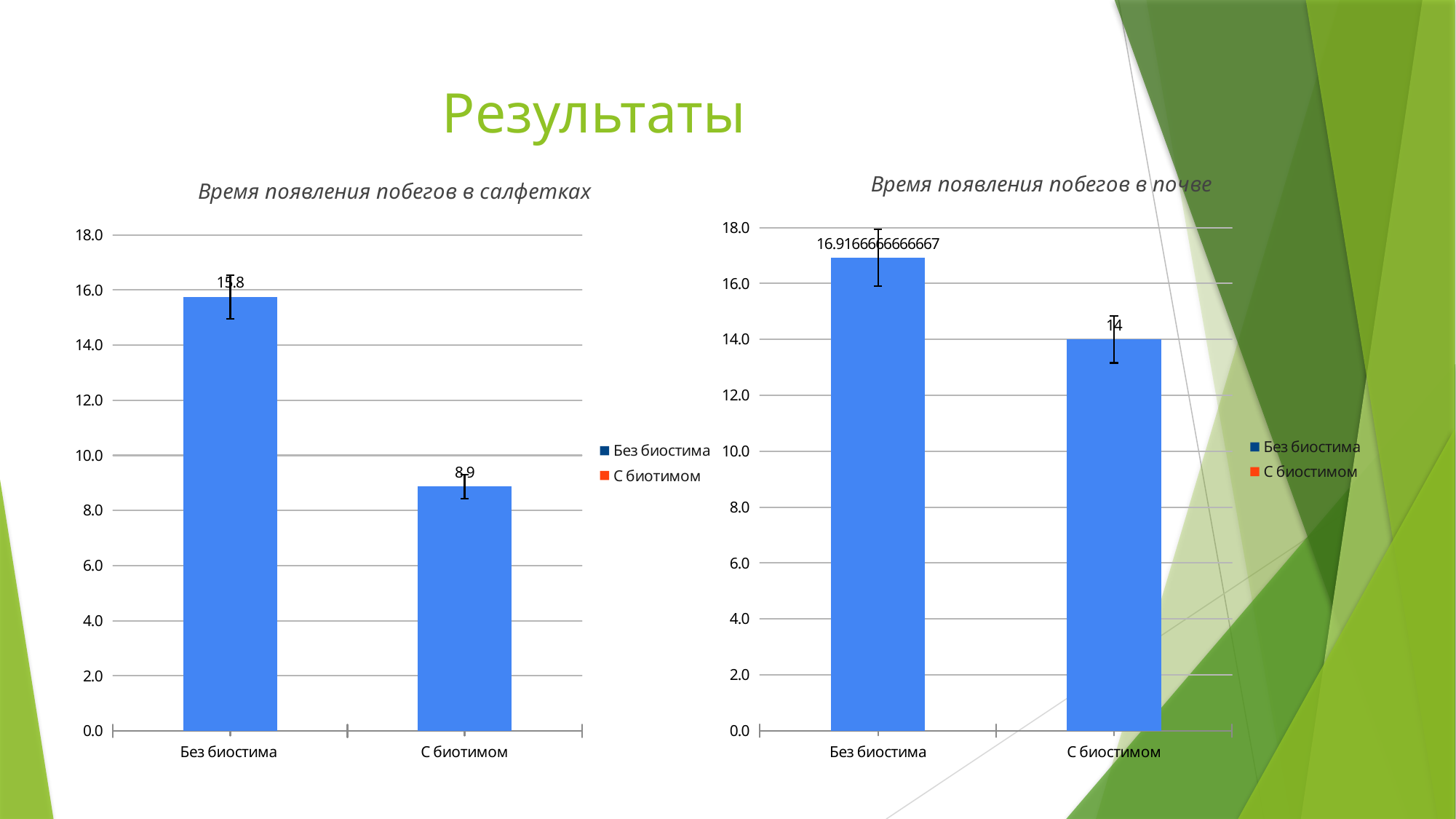
What kind of chart is the chart on the right side of the slide? Bar chart In the chart titled 'Время появления побегов в салфетках', what is the difference between the values for 'Без биостима' and 'С биотимом'? 6.9 How many categories are shown in the chart titled 'Время появления побегов в почве'? 2 In the chart titled 'Время появления побегов в почве', which is larger: the value for 'Без биостима' or for 'С биостимом'? Без биостима In the chart titled 'Время появления побегов в салфетках', what is the value for 'С биотимом'? 8.9 In the chart titled 'Время появления побегов в салфетках', which category has the highest value? Без биостима In the chart titled 'Время появления побегов в салфетках', is the value for 'С биотимом' greater or less than 10.0? less In the chart titled 'Время появления побегов в почве', what is the value for 'С биостимом'? 14 In the chart titled 'Время появления побегов в почве', what is the value for 'Без биостима'? 16.9166666666667 In the chart titled 'Время появления побегов в почве', which category has the lowest value? С биостимом How many entries does the legend of the chart titled 'Время появления побегов в салфетках' list? 2 In the chart titled 'Время появления побегов в салфетках', what is the value for 'Без биостима'? 15.8